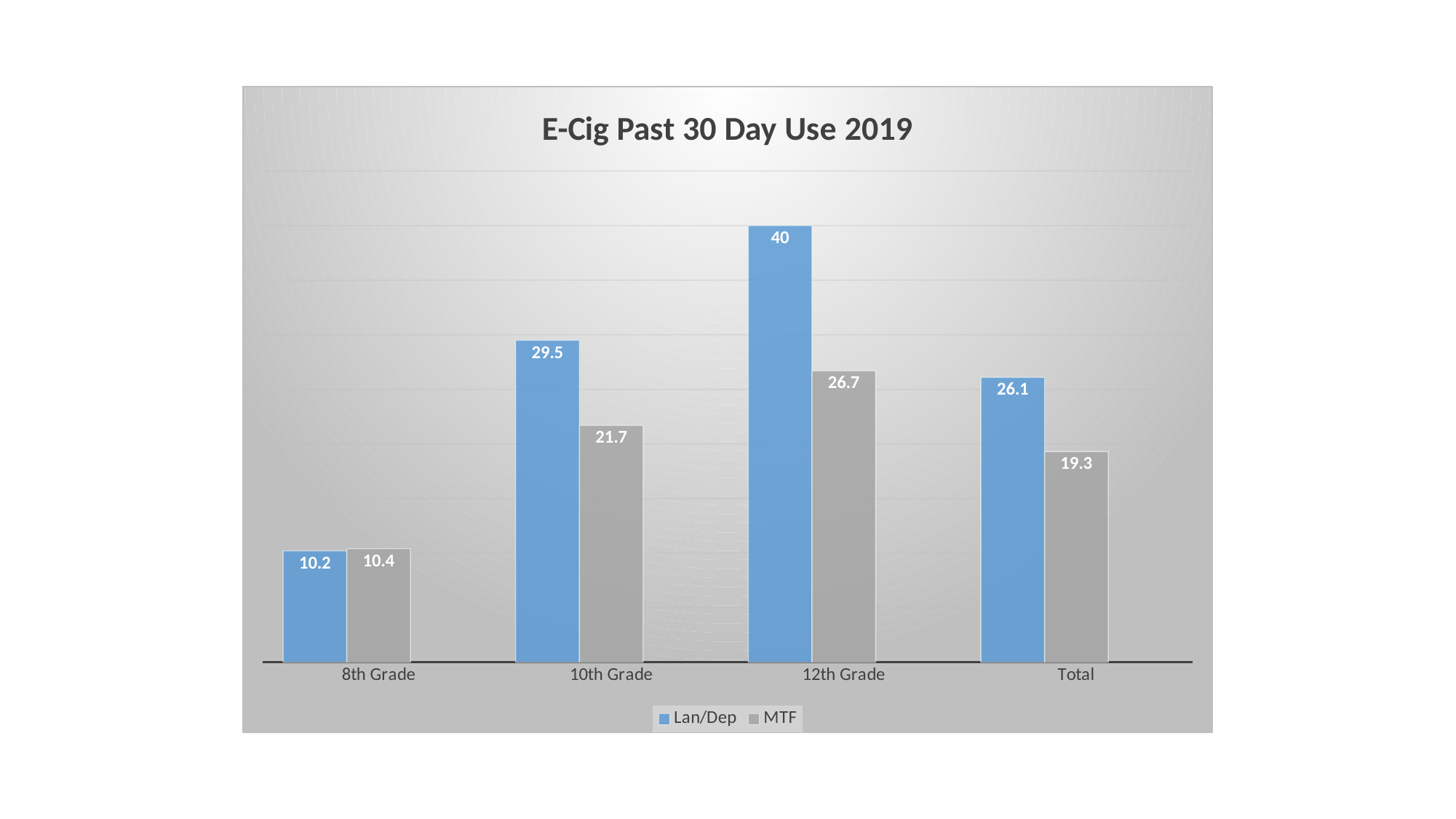
What is the MTF value for 8th Grade? 10.4 What is the MTF value for 10th Grade? 21.7 For 10th Grade, which is larger, Lan/Dep or MTF? Lan/Dep What is the Lan/Dep value for 12th Grade? 40 What kind of chart is shown on the slide? Bar chart What is the difference between the Lan/Dep and MTF values for Total? 6.8 Which grade has the highest Lan/Dep value? 12th Grade What is the difference between the Lan/Dep and MTF values for 12th Grade? 13.3 How many series does the legend list? 2 How many categories are shown on the x axis? 4 Which category has the lowest MTF value? 8th Grade What is the Lan/Dep value for Total? 26.1